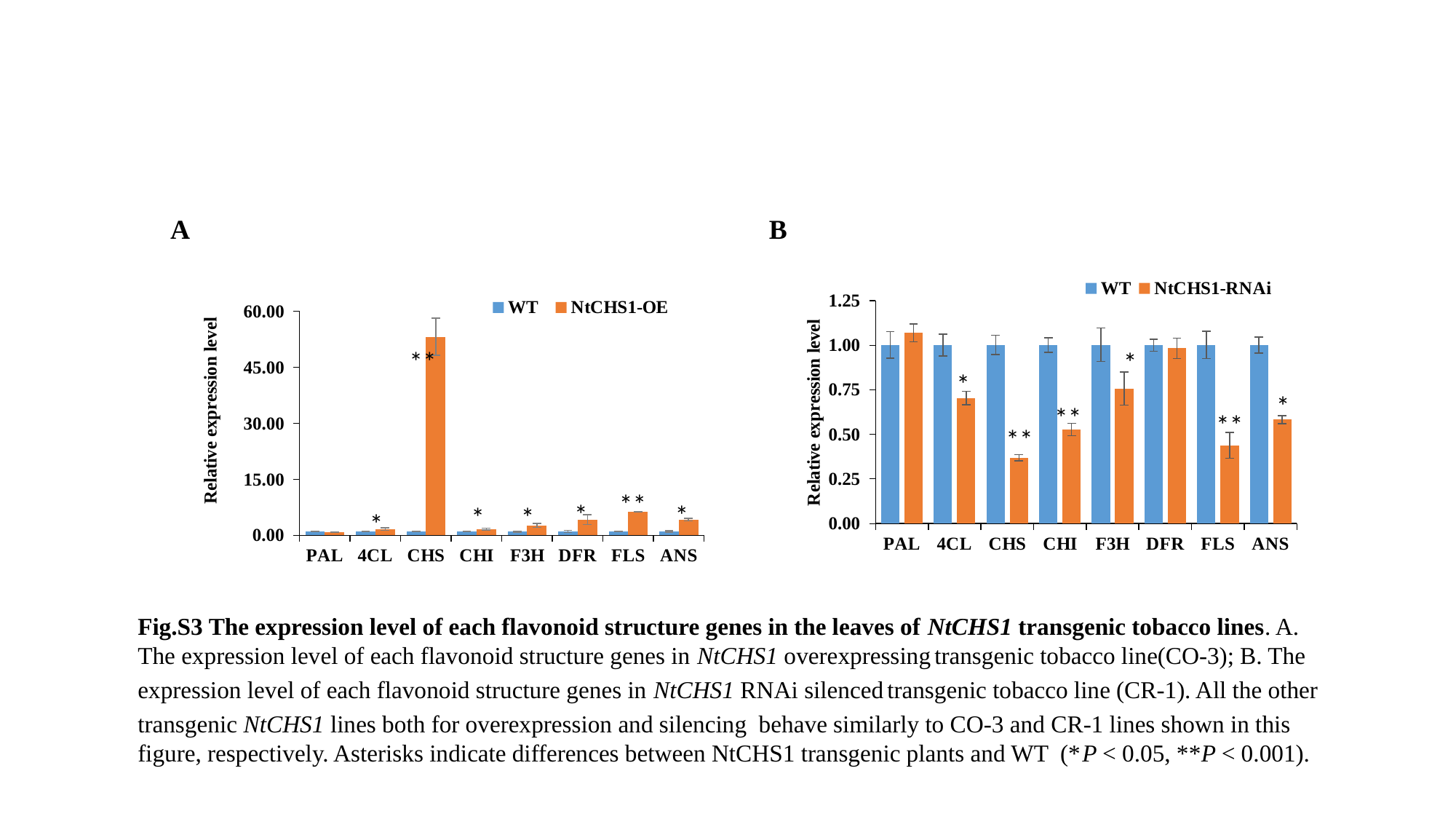
In chart B, what are the two series named in the legend? WT and NtCHS1-RNAi In chart A, is the NtCHS1-OE value for CHS greater or less than 45.00? greater In chart A, how many series does the legend list? 2 In chart B, which gene has the lowest NtCHS1-RNAi relative expression level? CHS In chart A, how many genes are shown on the x axis? 8 In chart B, which is larger for NtCHS1-RNAi: 4CL or CHI? 4CL What kind of chart is chart A on the left? bar chart In chart A, which gene has the highest NtCHS1-OE relative expression level? CHS In chart B, what is the label of the y axis? Relative expression level In chart B, what is the WT relative expression level for PAL? 1.00 In chart A, which is larger for NtCHS1-OE: FLS or DFR? FLS In chart B, is the NtCHS1-RNAi value for CHI greater or less than 0.75? less